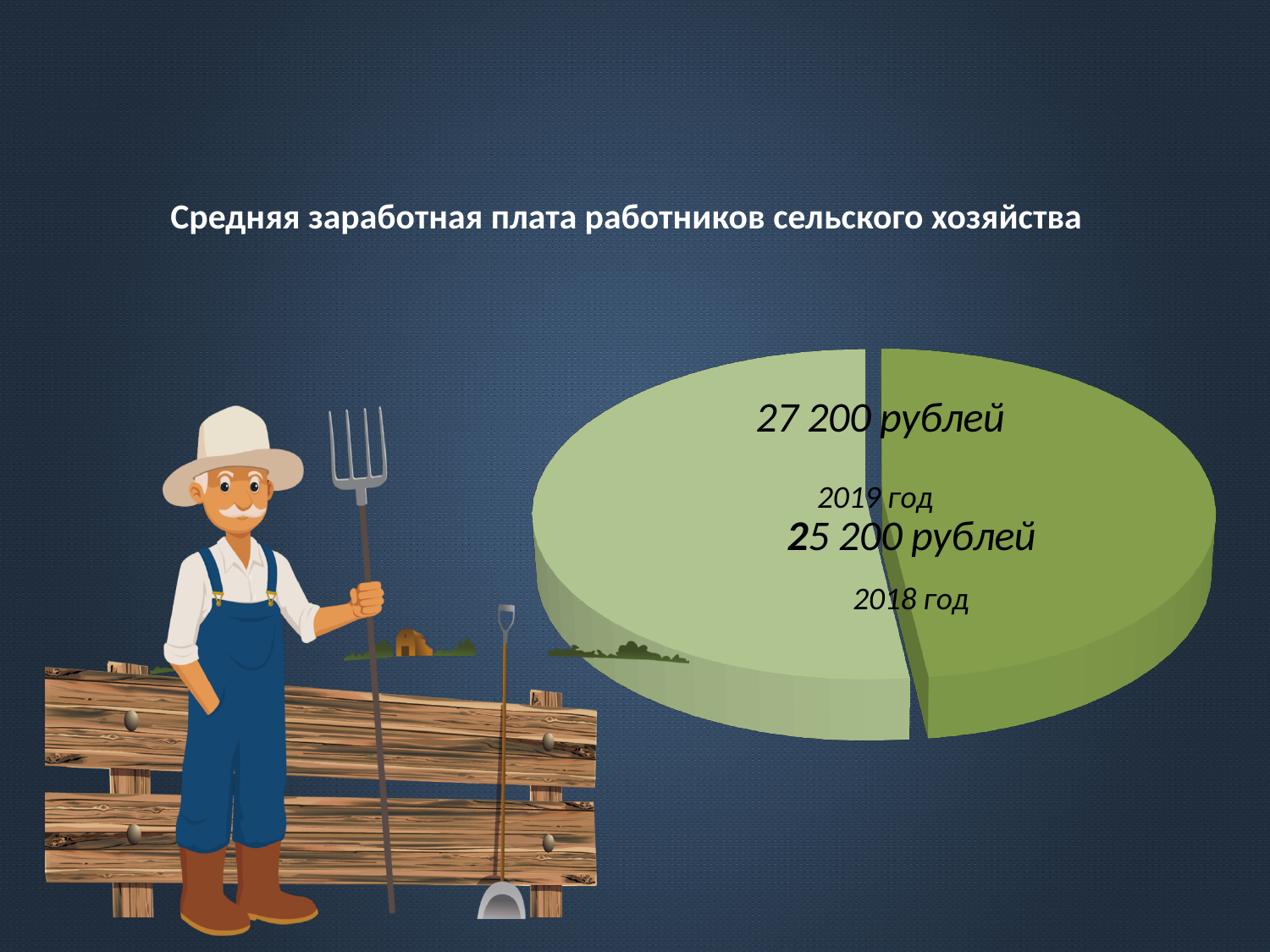
How many slices does the pie chart have? 2 What is the title of the chart on the slide? Средняя заработная плата работников сельского хозяйства Which year has the higher average salary on the chart? 2019 год By how much does the 2019 average salary exceed the 2018 average salary? 2 000 рублей Did the average salary rise or fall from 2018 to 2019? rise What is the average salary shown for 2018 (2018 год)? 25 200 рублей What is the average salary shown for 2019 (2019 год)? 27 200 рублей Which year has the lower average salary on the chart? 2018 год What kind of chart is shown on the slide? pie chart Is the value for 2018 год larger or smaller than the value for 2019 год? smaller Which two years are compared in the chart? 2018 год and 2019 год